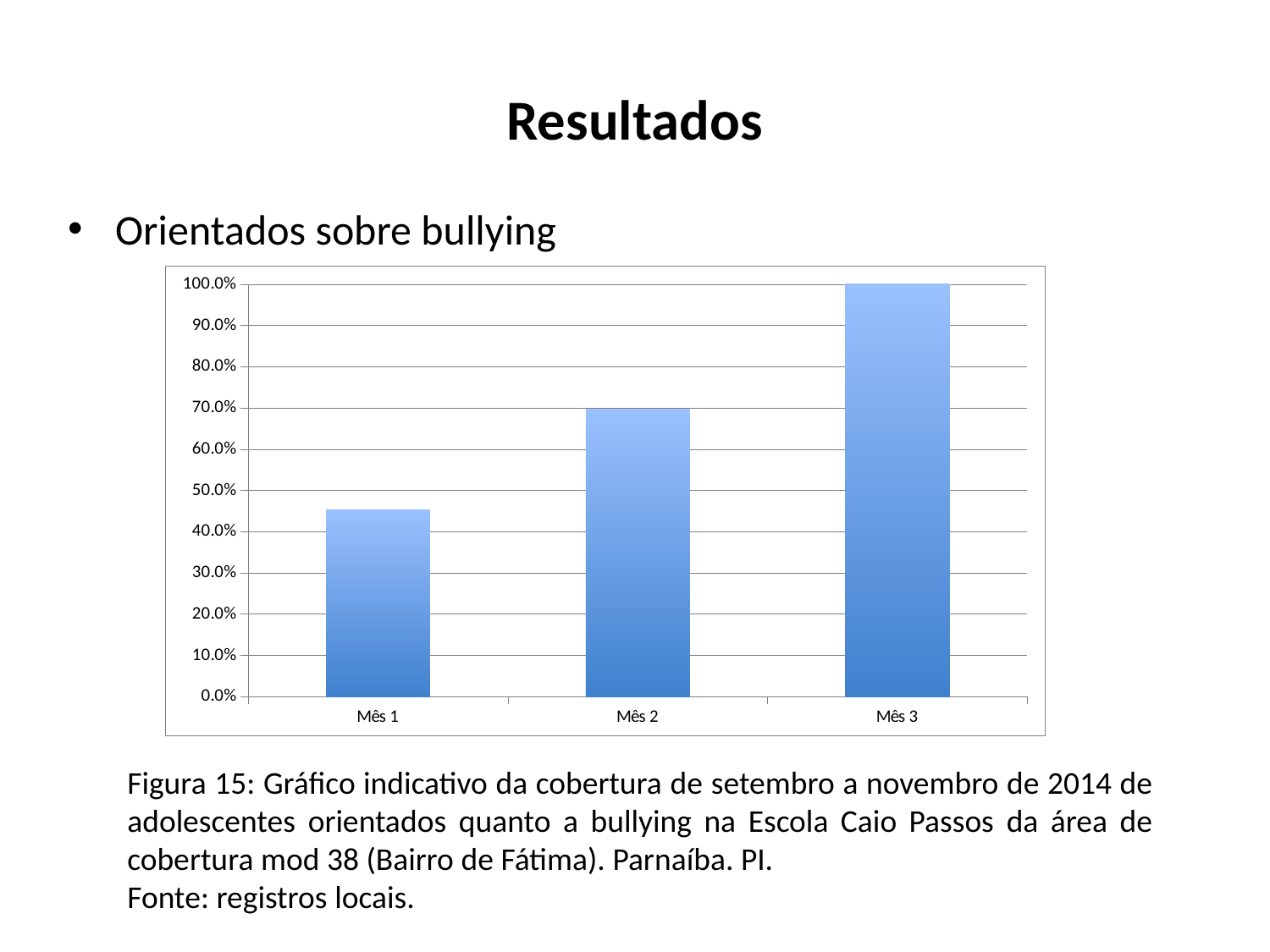
Which is larger, the value for Mês 1 or the value for Mês 2? Mês 2 What is the value for Mês 3? 100.0% What kind of chart is shown on the slide? bar chart Do the values rise or fall from Mês 1 to Mês 3? rise Which month has the lowest value in the chart? Mês 1 Is the value for Mês 1 greater or less than 50.0%? less How many categories are shown on the x axis of the chart? 3 Is the value for Mês 1 greater or less than 40.0%? greater What is the label of the first category on the x axis? Mês 1 Which month has the highest value in the chart? Mês 3